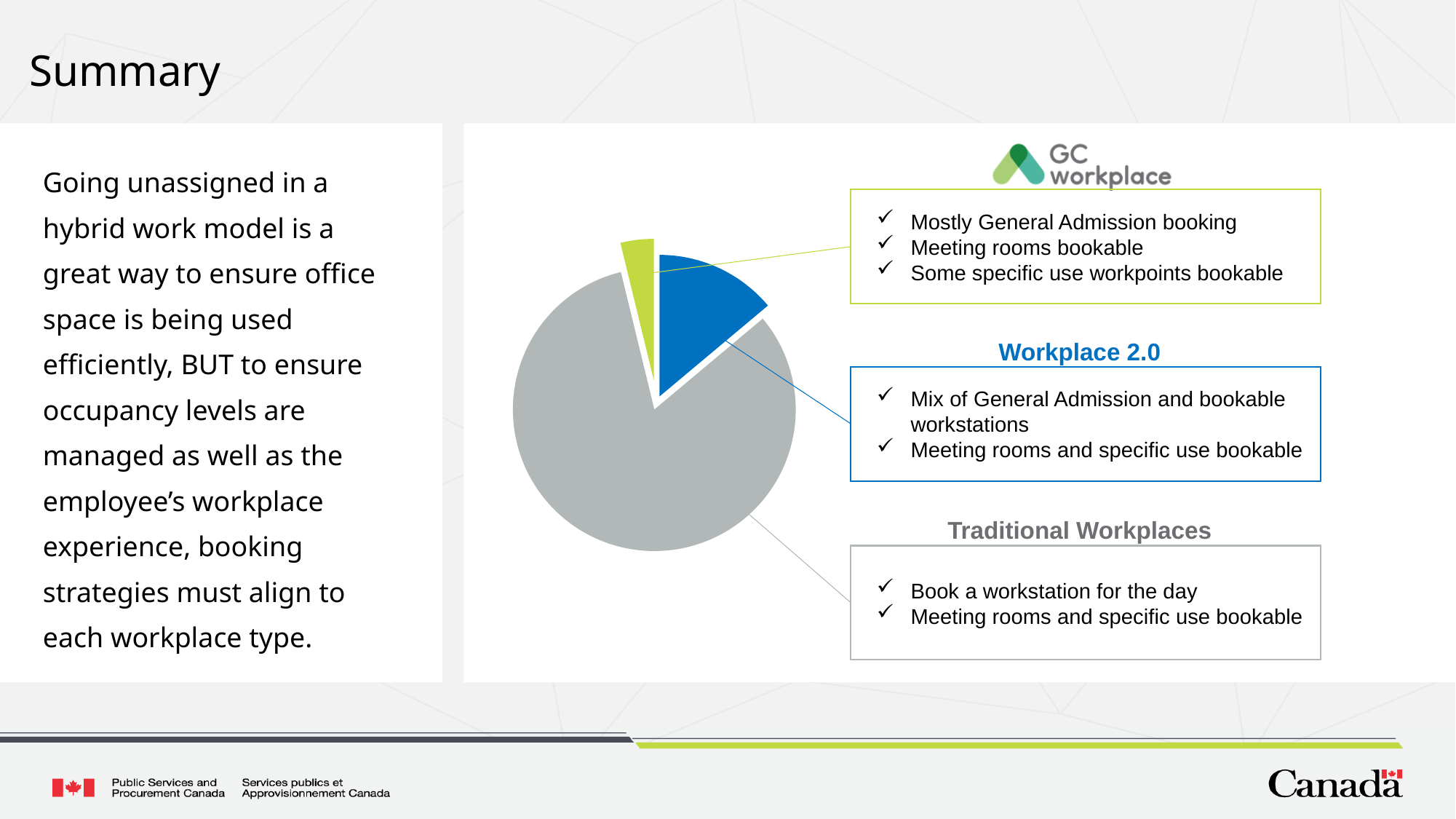
Which workplace type has the smallest slice of the pie chart? GC workplace Which slice is larger in the pie chart, Workplace 2.0 or GC workplace? Workplace 2.0 How many slices does the pie chart have? 3 What colour is the slice for Traditional Workplaces in the pie chart? grey Which workplace type has the largest slice of the pie chart? Traditional Workplaces Which slice is larger in the pie chart, Traditional Workplaces or Workplace 2.0? Traditional Workplaces What colour is the slice for Workplace 2.0 in the pie chart? blue What kind of chart is shown on the slide? pie chart